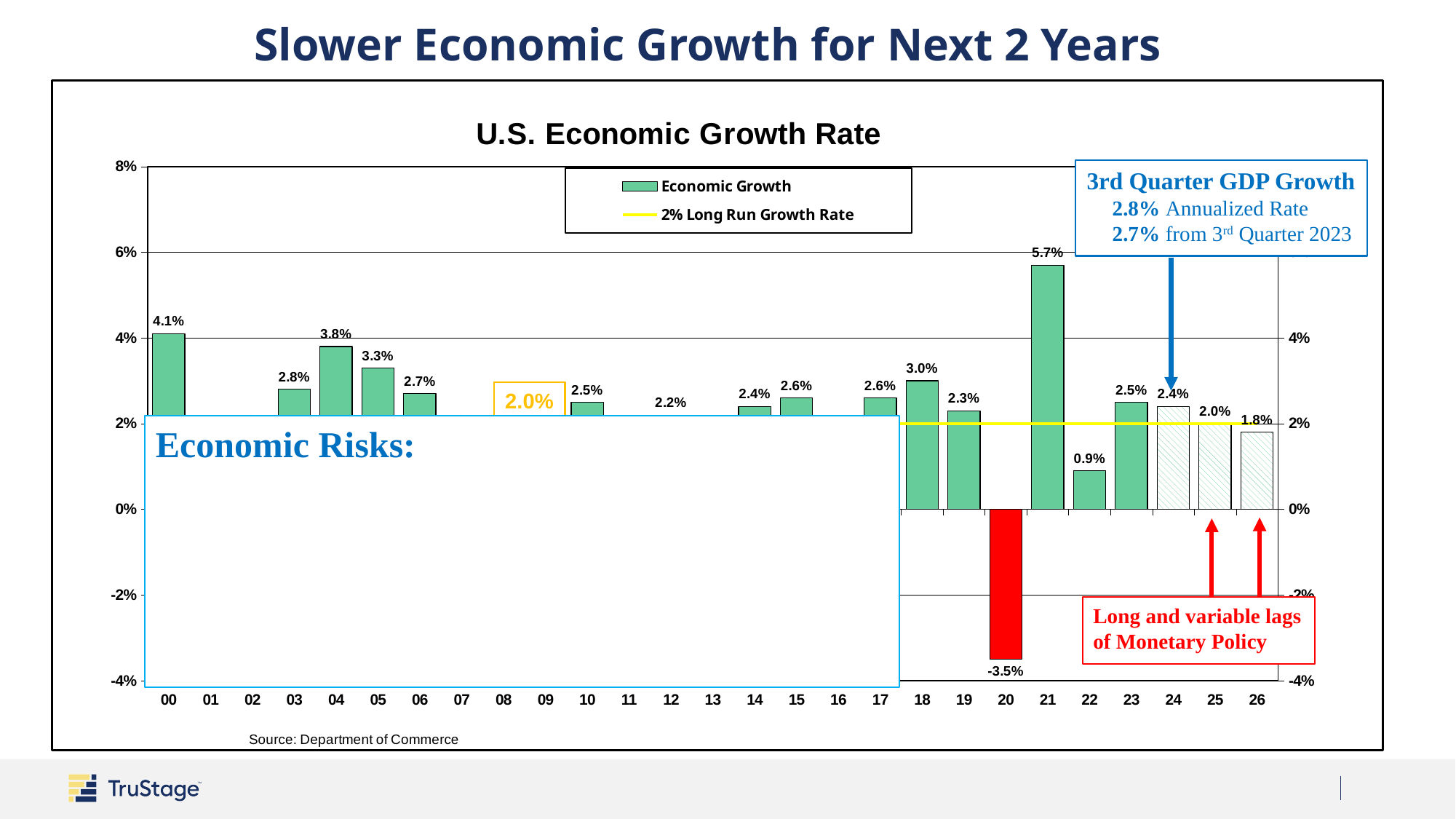
What is the economic growth rate shown for 26? 1.8% Do the growth rates rise or fall from 24 to 26? Fall How many years are shown on the x axis of the chart? 27 Which year has the lowest economic growth rate on the chart? 20 Which year has the larger growth rate, 04 or 05? 04 What is the economic growth rate shown for 21? 5.7% How many entries does the chart legend list? 2 What is the economic growth rate shown for 20? -3.5% Which year has the highest economic growth rate on the chart? 21 What is the difference between the growth rates for 21 and 23? 3.2 percentage points Is the value for 21 greater or less than 4%? greater What kind of chart is used to show the U.S. Economic Growth Rate? Bar chart